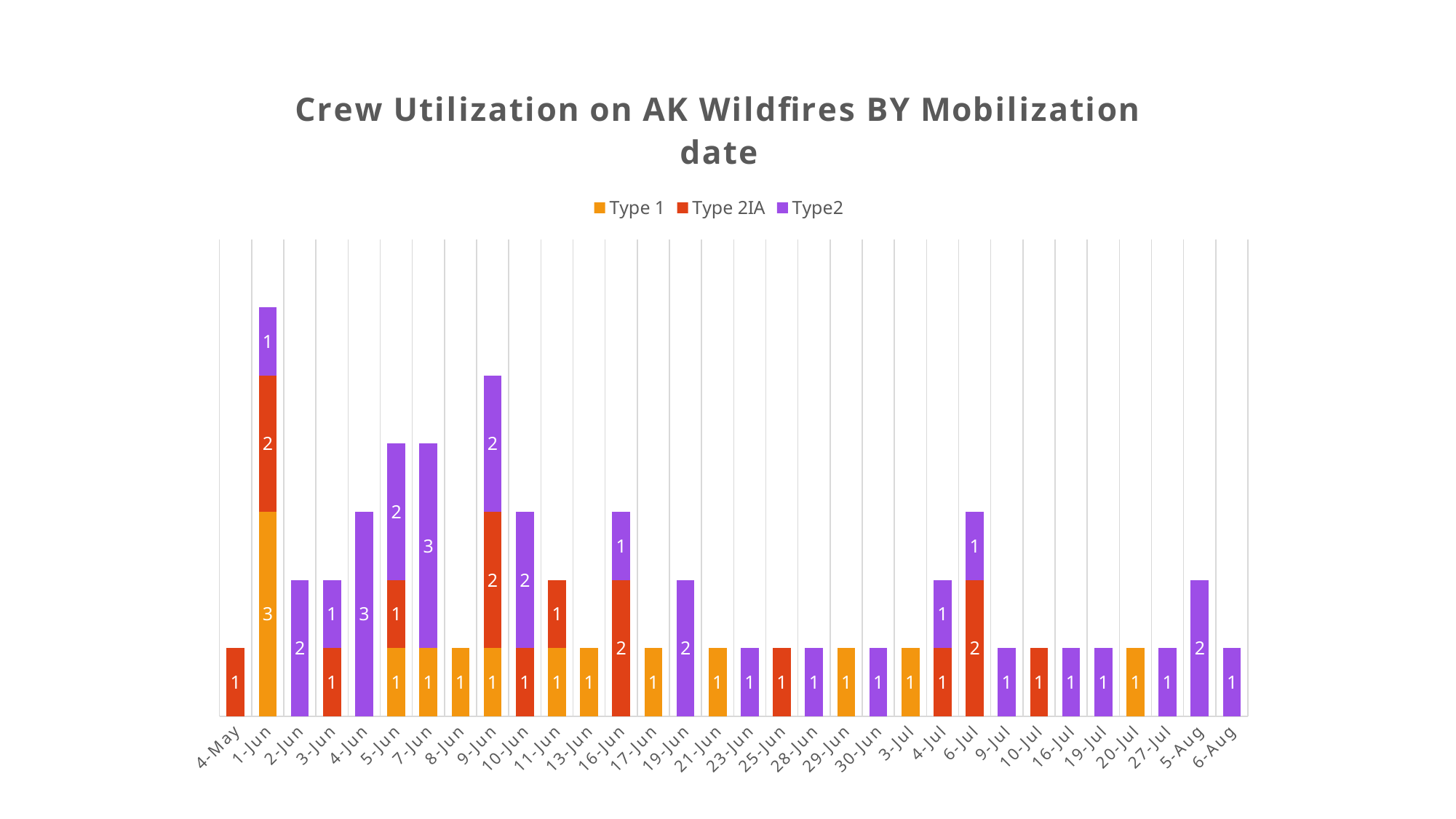
What is the difference between the Type2 value for 4-Jun and the Type2 value for 2-Jun? 1 Which is larger, the Type 2IA value for 6-Jul or the Type 2IA value for 10-Jul? 6-Jul What is the Type 2IA value for 16-Jun? 2 What is the total of the stacked bar for 1-Jun? 6 What is the Type 1 value for 1-Jun? 3 What is the title of the chart? Crew Utilization on AK Wildfires BY Mobilization date What is the Type2 value for 7-Jun? 3 How many dates are shown on the x axis? 32 Which date has the tallest stacked bar? 1-Jun What type of chart is shown on the slide? stacked bar chart What is the total of the stacked bar for 9-Jun? 5 How many series does the legend list? 3